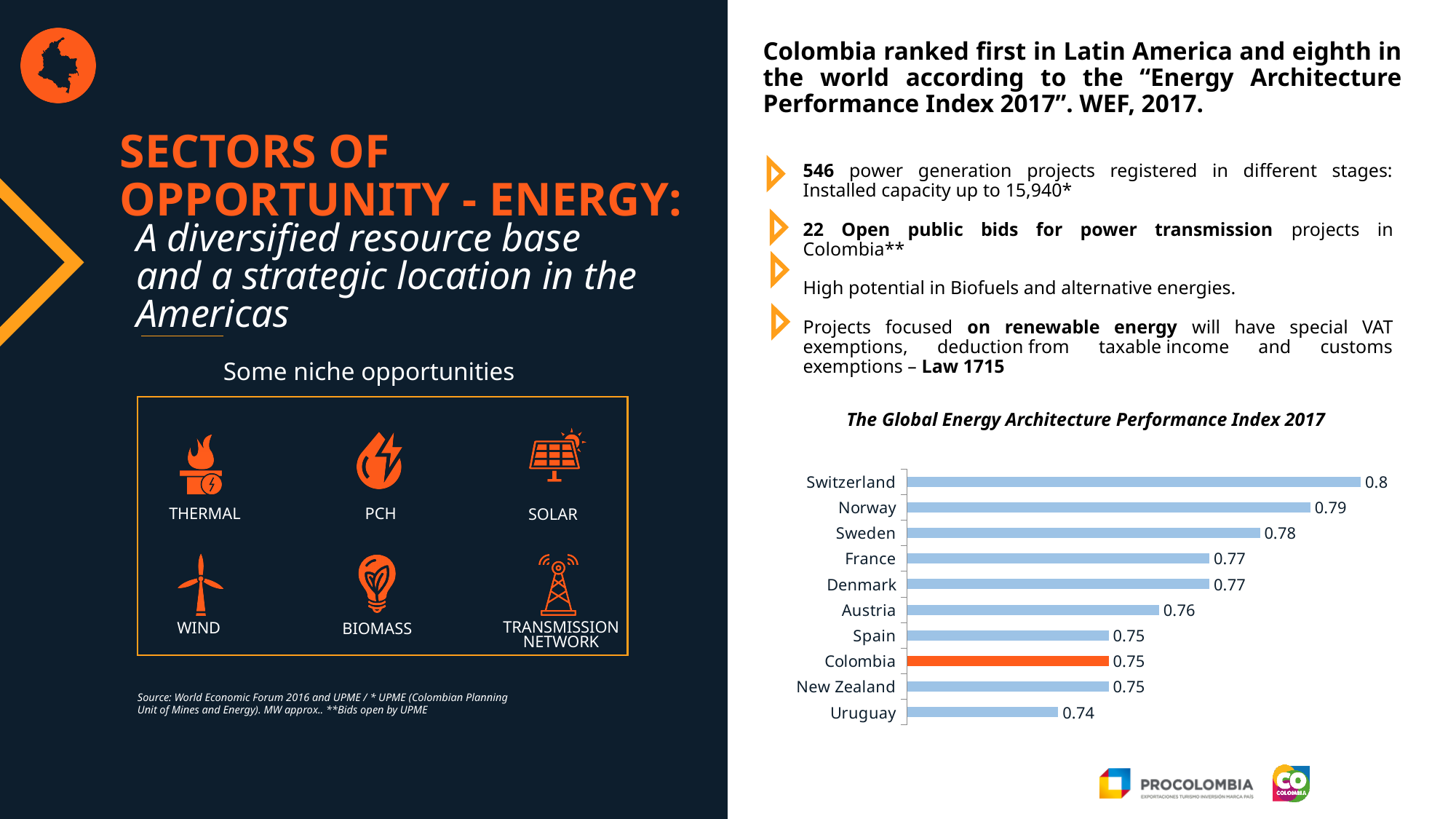
What is the value for Austria in The Global Energy Architecture Performance Index 2017 chart? 0.76 What kind of chart is The Global Energy Architecture Performance Index 2017 chart? Bar chart What is the value for Uruguay in The Global Energy Architecture Performance Index 2017 chart? 0.74 What is the difference between the values for Sweden and Uruguay in The Global Energy Architecture Performance Index 2017 chart? 0.04 What is the value for Switzerland in The Global Energy Architecture Performance Index 2017 chart? 0.8 In The Global Energy Architecture Performance Index 2017 chart, which country's bar is coloured orange instead of blue? Colombia In The Global Energy Architecture Performance Index 2017 chart, which has a larger value, Norway or Sweden? Norway Which country has the lowest value in The Global Energy Architecture Performance Index 2017 chart? Uruguay What is the difference between the values for Switzerland and Colombia in The Global Energy Architecture Performance Index 2017 chart? 0.05 What is the value for Colombia in The Global Energy Architecture Performance Index 2017 chart? 0.75 Which country has the highest value in The Global Energy Architecture Performance Index 2017 chart? Switzerland How many countries are shown in The Global Energy Architecture Performance Index 2017 chart? 10